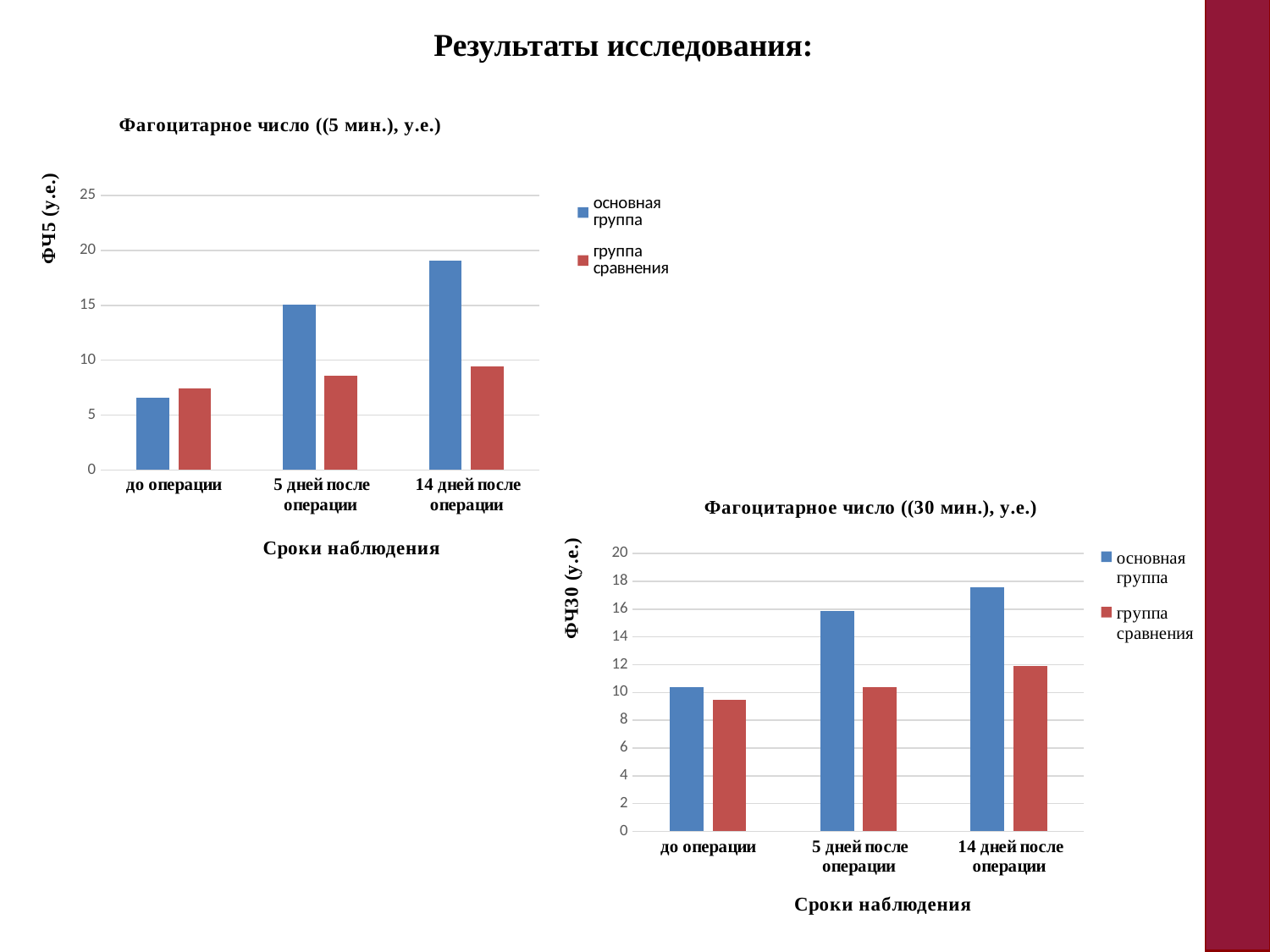
In the chart titled 'Фагоцитарное число ((30 мин.), у.е.)', which category has the lowest value for 'группа сравнения'? до операции In the chart titled 'Фагоцитарное число ((5 мин.), у.е.)', at '5 дней после операции', which series has the larger value: 'основная группа' or 'группа сравнения'? основная группа In the chart titled 'Фагоцитарное число ((30 мин.), у.е.)', is the value for 'группа сравнения' at 'до операции' greater or less than 10? less In the chart titled 'Фагоцитарное число ((30 мин.), у.е.)', is the value for 'основная группа' at '5 дней после операции' greater or less than 14? greater In the chart titled 'Фагоцитарное число ((5 мин.), у.е.)', which category has the highest value for 'основная группа'? 14 дней после операции What kind of chart is the chart titled 'Фагоцитарное число ((5 мин.), у.е.)'? bar chart In the chart titled 'Фагоцитарное число ((5 мин.), у.е.)', do the values for 'основная группа' rise or fall from 'до операции' to '14 дней после операции'? rise In the chart titled 'Фагоцитарное число ((5 мин.), у.е.)', is the value for 'основная группа' at '14 дней после операции' greater or less than 15? greater What is the x-axis title of the chart titled 'Фагоцитарное число ((5 мин.), у.е.)'? Сроки наблюдения In the chart titled 'Фагоцитарное число ((30 мин.), у.е.)', how many categories are shown on the x axis? 3 What is the y-axis title of the chart titled 'Фагоцитарное число ((30 мин.), у.е.)'? ФЧ30 (у.е.) In the chart titled 'Фагоцитарное число ((5 мин.), у.е.)', how many series does the legend list? 2